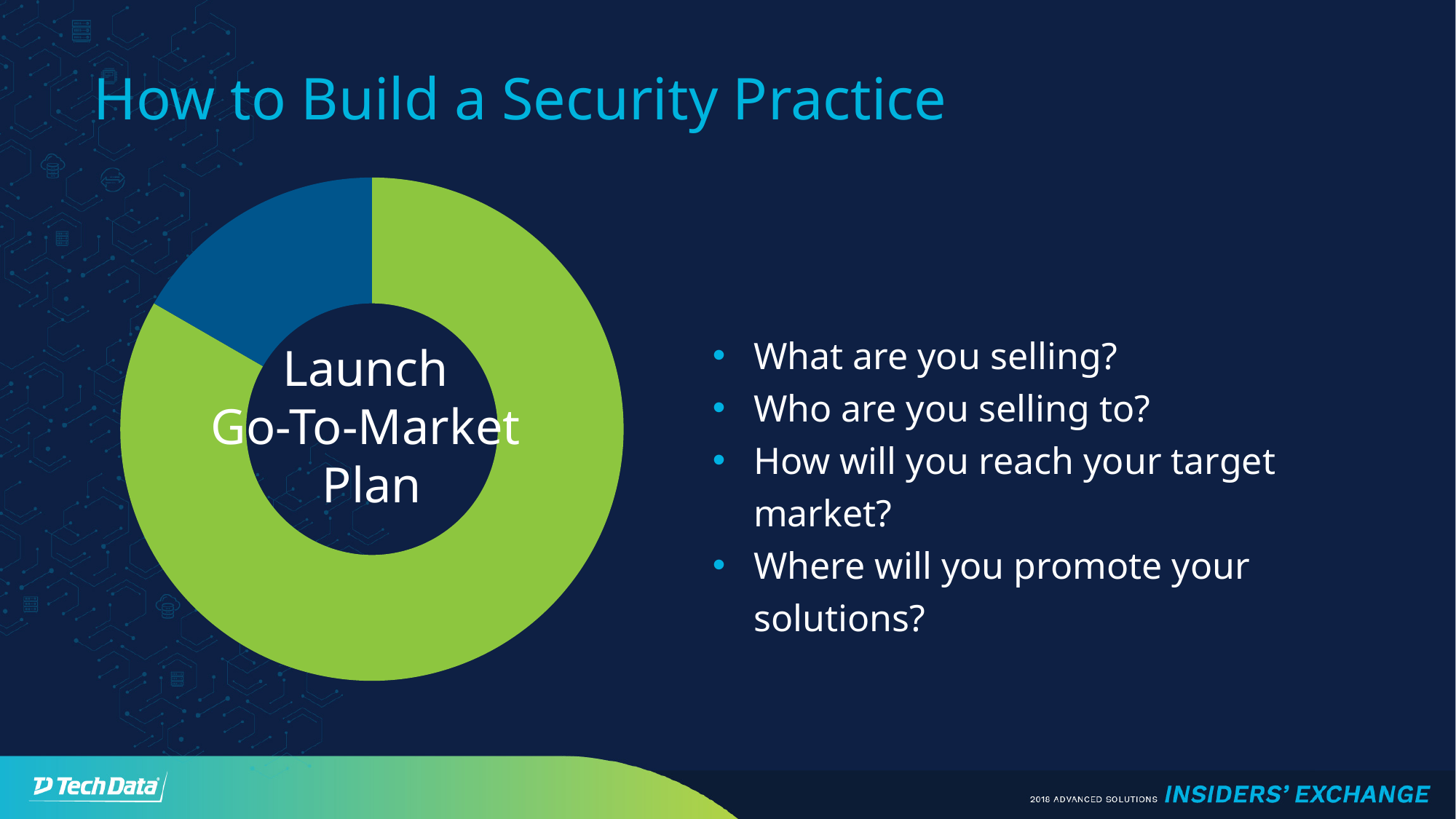
Which colour slice takes up the largest share of the doughnut chart? green Does the doughnut chart show a legend? No Which colour slice takes up the smallest share of the doughnut chart? blue What text is written in the centre of the doughnut chart? Launch Go-To-Market Plan What kind of chart is shown on the slide? doughnut chart How many slices does the doughnut chart have? 2 Which slice of the doughnut chart is larger, the green one or the blue one? green